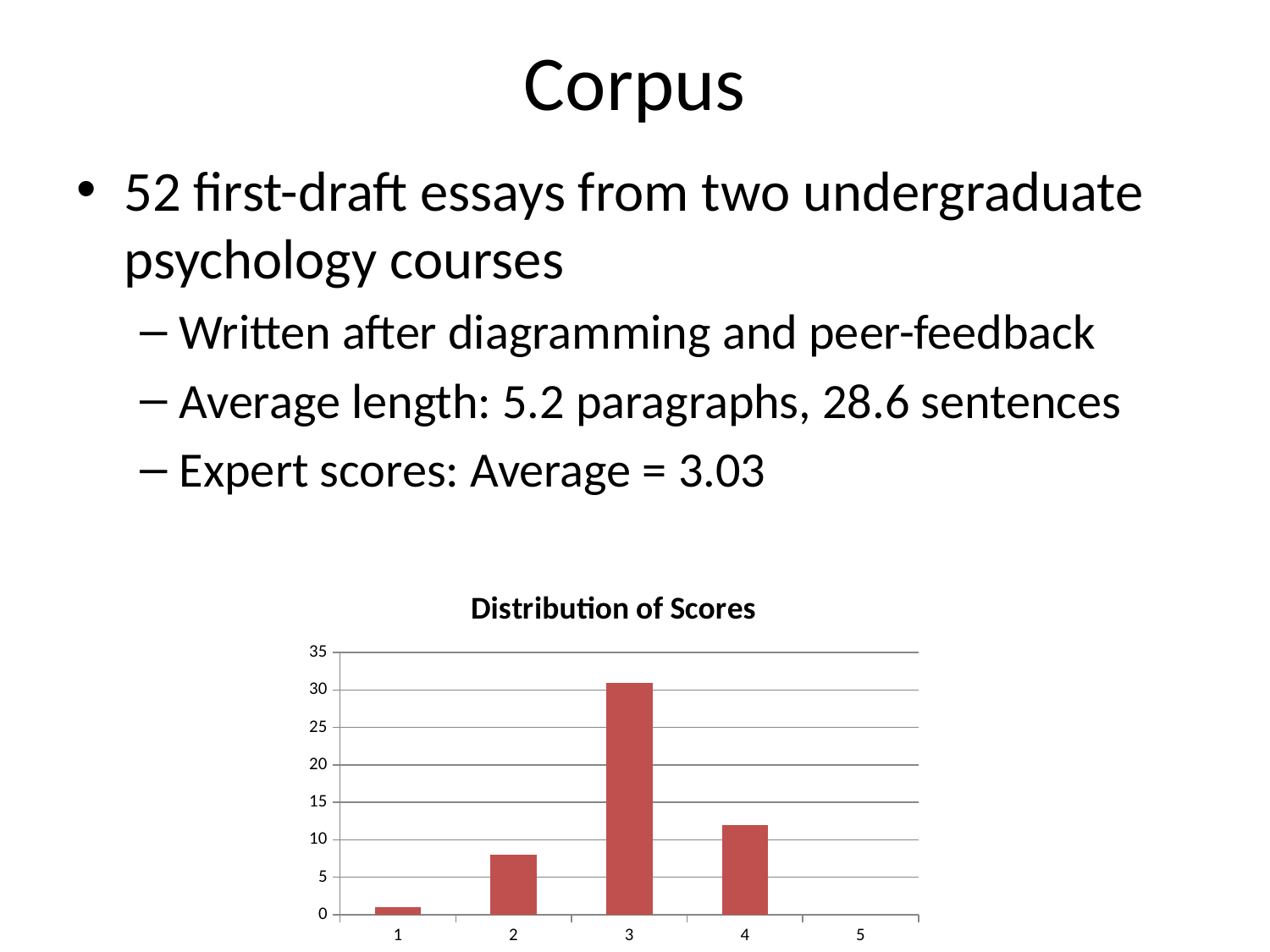
Is the value for score 3 greater or less than 25? greater Which score category has the highest bar in the Distribution of Scores chart? 3 Is the value for score 2 greater or less than 10? less Which has the larger value, score 3 or score 4? 3 Which has the larger value, score 2 or score 4? 4 Is the value for score 1 greater or less than 5? less What is the title of the chart on the slide? Distribution of Scores What is the highest value shown on the y axis of the Distribution of Scores chart? 35 What kind of chart is shown under the title "Distribution of Scores"? bar chart Which score category has the lowest value in the Distribution of Scores chart? 5 How many score categories are shown on the x axis of the Distribution of Scores chart? 5